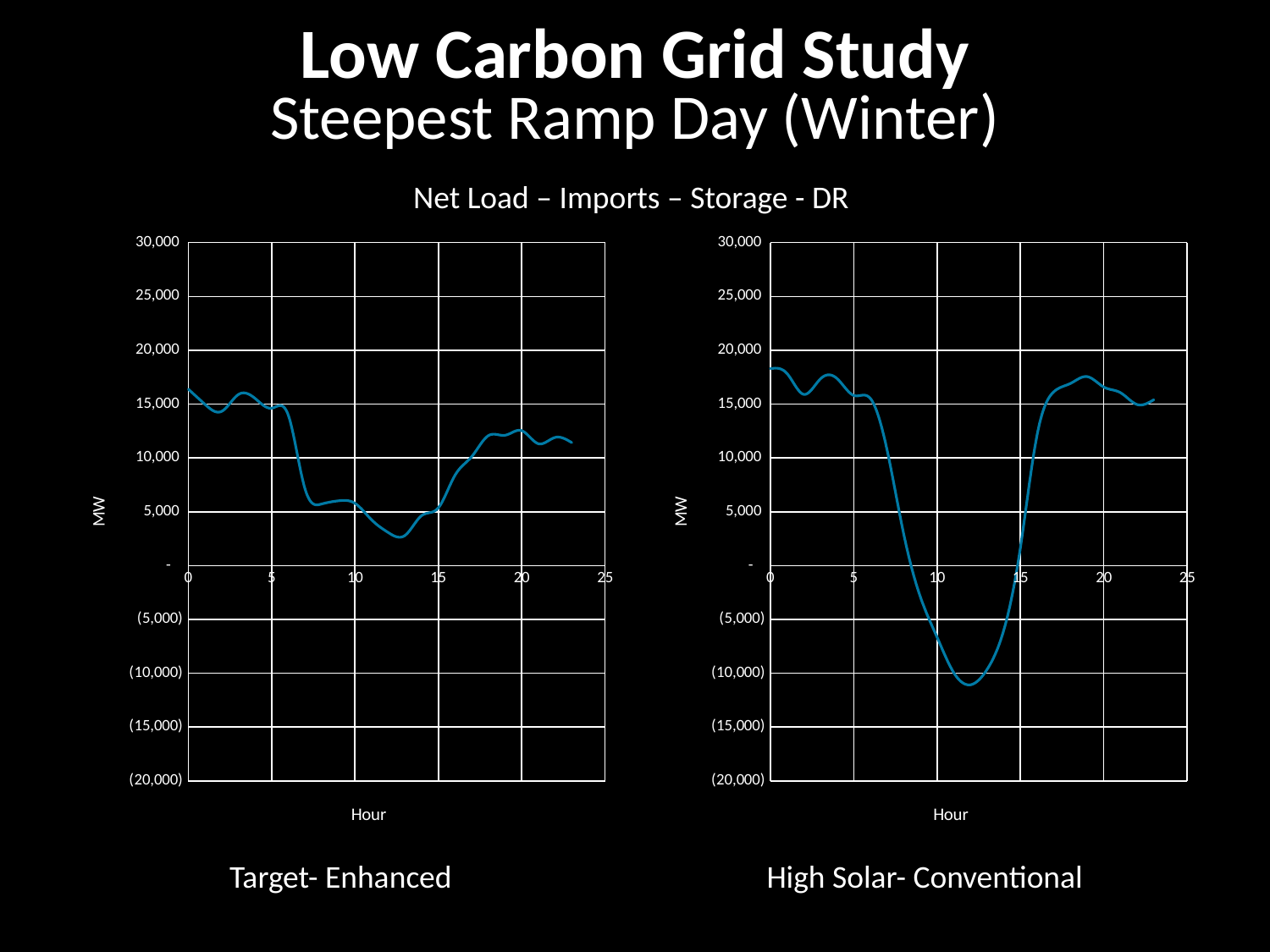
In the High Solar- Conventional chart, is the value at hour 0 greater or less than 15,000? greater Which chart reaches the lower minimum value, Target- Enhanced or High Solar- Conventional? High Solar- Conventional In the High Solar- Conventional chart, is the value at hour 19 greater or less than 15,000? greater In the Target- Enhanced chart, is the value at hour 13 greater or less than 5,000? less What is the label on the y axis of both charts? MW In the Target- Enhanced chart, do the values rise or fall between hour 5 and hour 13? fall In the High Solar- Conventional chart, do the values rise or fall between hour 12 and hour 19? rise What kind of chart is the Target- Enhanced chart on the left? line chart What kind of chart is the High Solar- Conventional chart on the right? line chart What is the label on the x axis of both charts? Hour